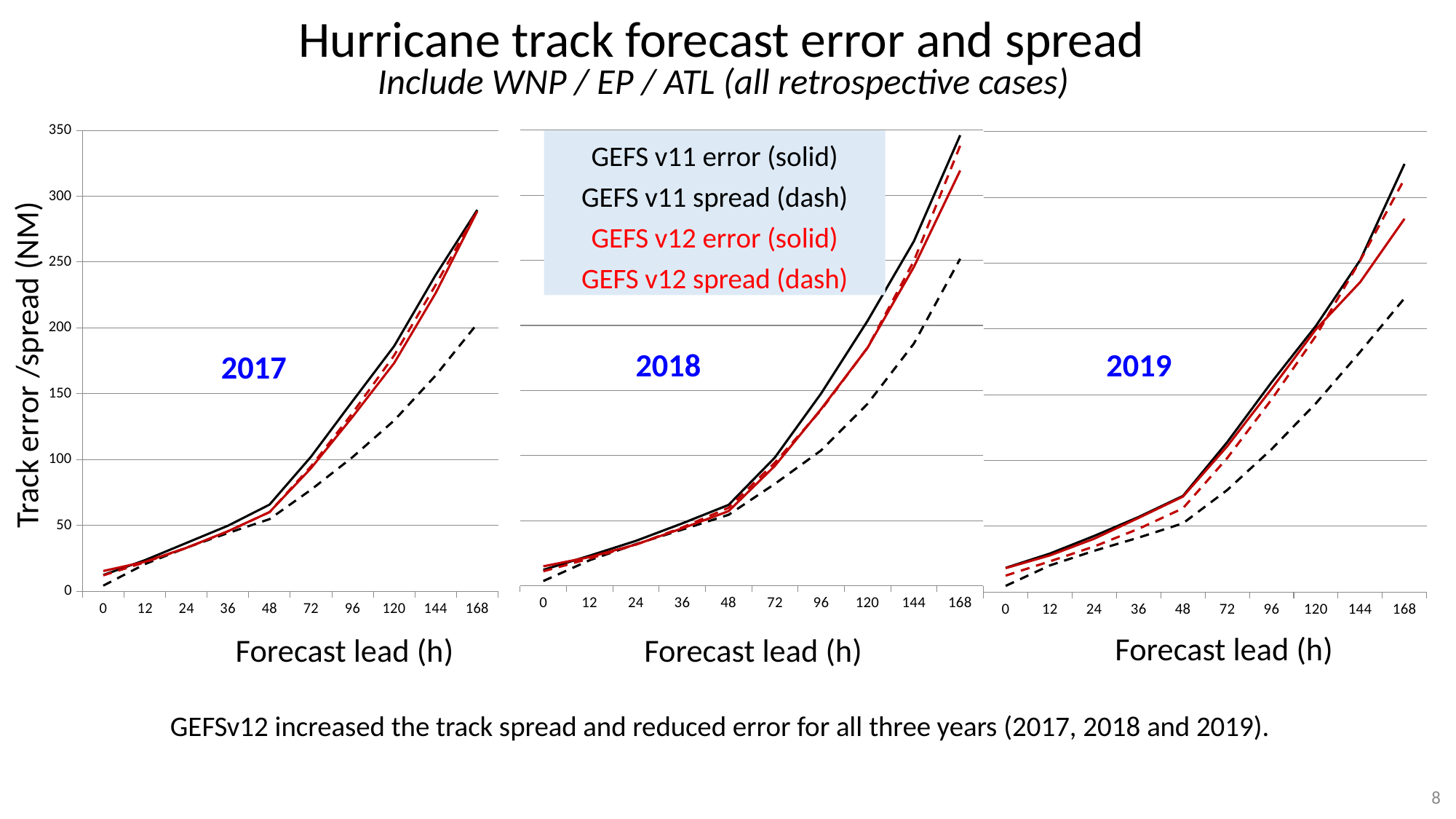
In the 2019 chart, do the lines rise or fall as forecast lead increases? Rise In the 2019 chart, which series has the lowest value at 168 h? GEFS v11 spread (dash) In the 2018 chart, which is larger at 168 h: GEFS v11 error or GEFS v11 spread? GEFS v11 error In the 2019 chart, is the GEFS v11 error at 168 h greater or less than 300? greater What is the label of the y axis shared by the three charts? Track error /spread (NM) In the 2017 chart, is the GEFS v11 error at 168 h greater or less than 250? greater How many series does the legend list? 4 In the 2019 chart, which is larger at 168 h: GEFS v11 error or GEFS v12 error? GEFS v11 error In the 2018 chart, which series has the lowest value at 168 h? GEFS v11 spread (dash) In the 2018 chart, is the GEFS v11 spread at 96 h greater or less than 150? less How many forecast lead times are plotted along the x axis of the 2018 chart? 10 What kind of chart is used for the 2017, 2018 and 2019 panels? Line chart